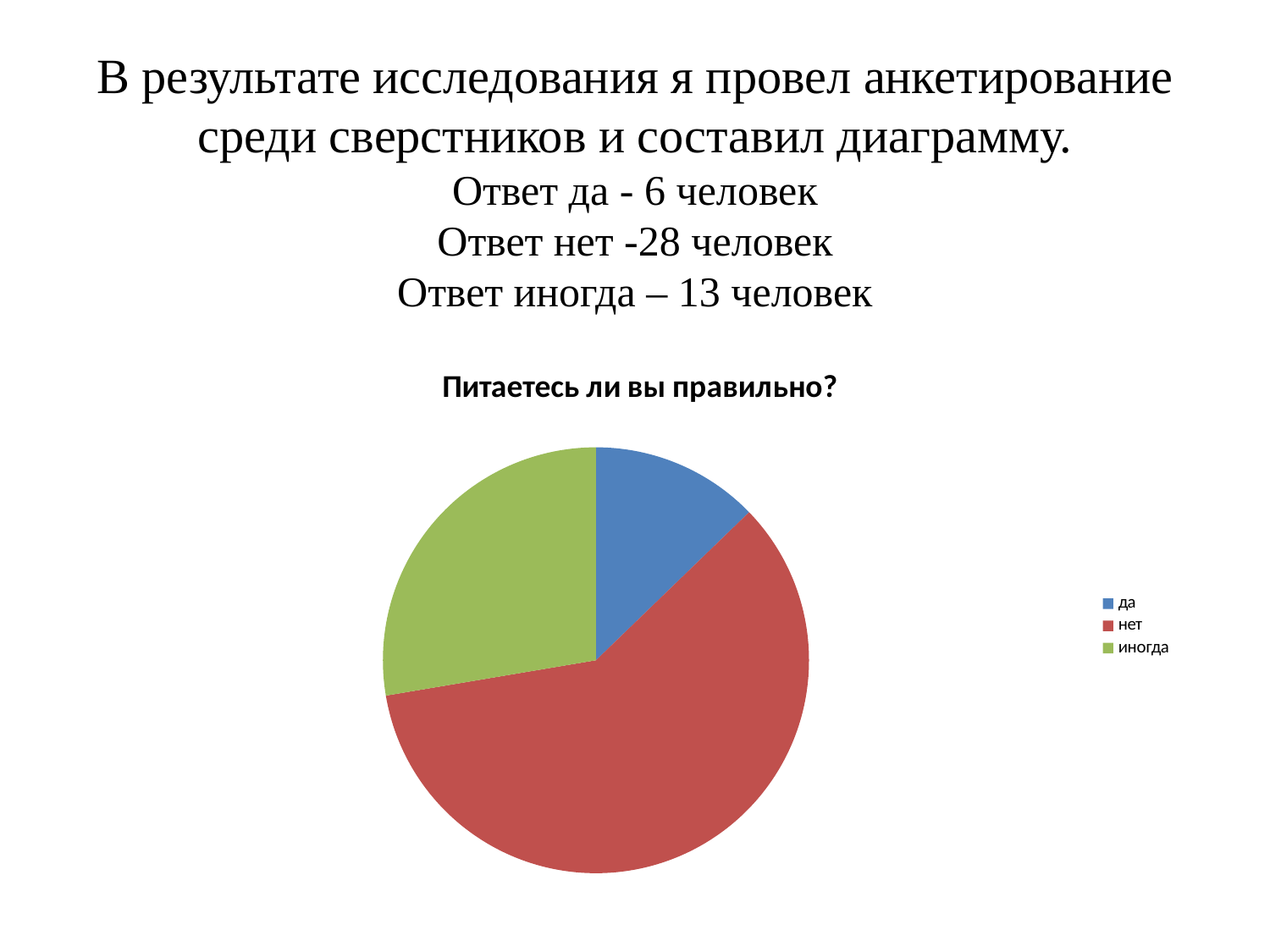
Which answer has the largest slice in the pie chart? нет How many people answered "нет" according to the slide? 28 человек What colour is the slice for "иногда" in the pie chart? green What is the title of the pie chart? Питаетесь ли вы правильно? What kind of chart is shown on the slide? pie chart How many more people answered "нет" than "иногда"? 15 How many entries does the legend of the pie chart list? 3 How many slices does the pie chart have? 3 Which answer has the smallest slice in the pie chart? да How many people answered "да" according to the slide? 6 человек Which answer was given by more people, "да" or "иногда"? иногда How many people answered "иногда" according to the slide? 13 человек